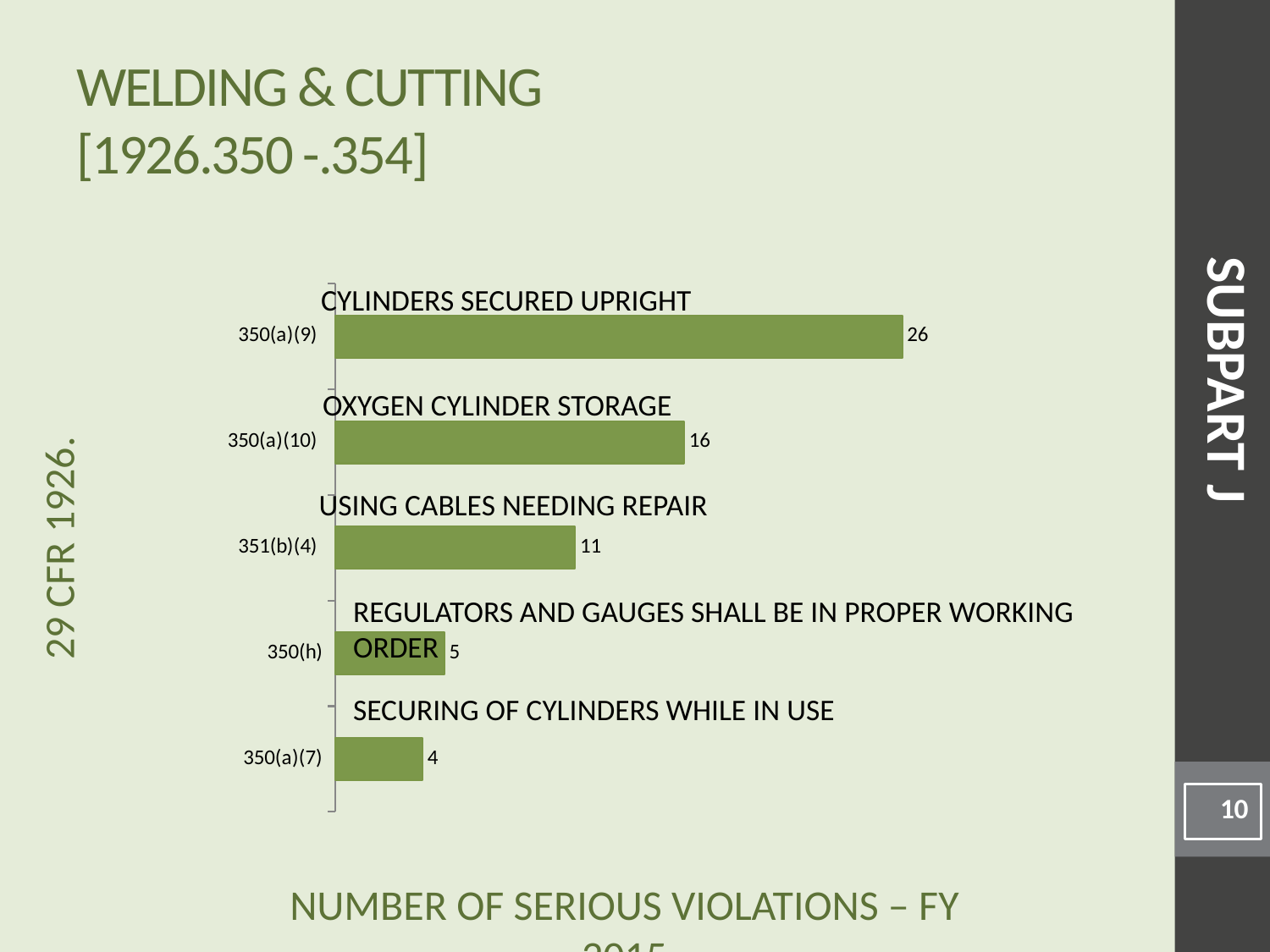
What is the value shown for 350(h)? 5 What kind of chart is shown on the slide? Bar chart What is the difference between the values for 350(a)(9) and 350(a)(10)? 10 What is the number of serious violations for 350(a)(9)? 26 What is the value shown for 350(a)(10)? 16 What is the value shown for 351(b)(4)? 11 What is the total of all the values plotted in the chart? 62 How many categories are plotted in the chart? 5 Which category has the lowest number of serious violations? 350(a)(7) Which category has the highest number of serious violations? 350(a)(9) What description is given for the bar labelled 350(a)(10)? OXYGEN CYLINDER STORAGE Which is larger, the value for 351(b)(4) or the value for 350(h)? 351(b)(4)